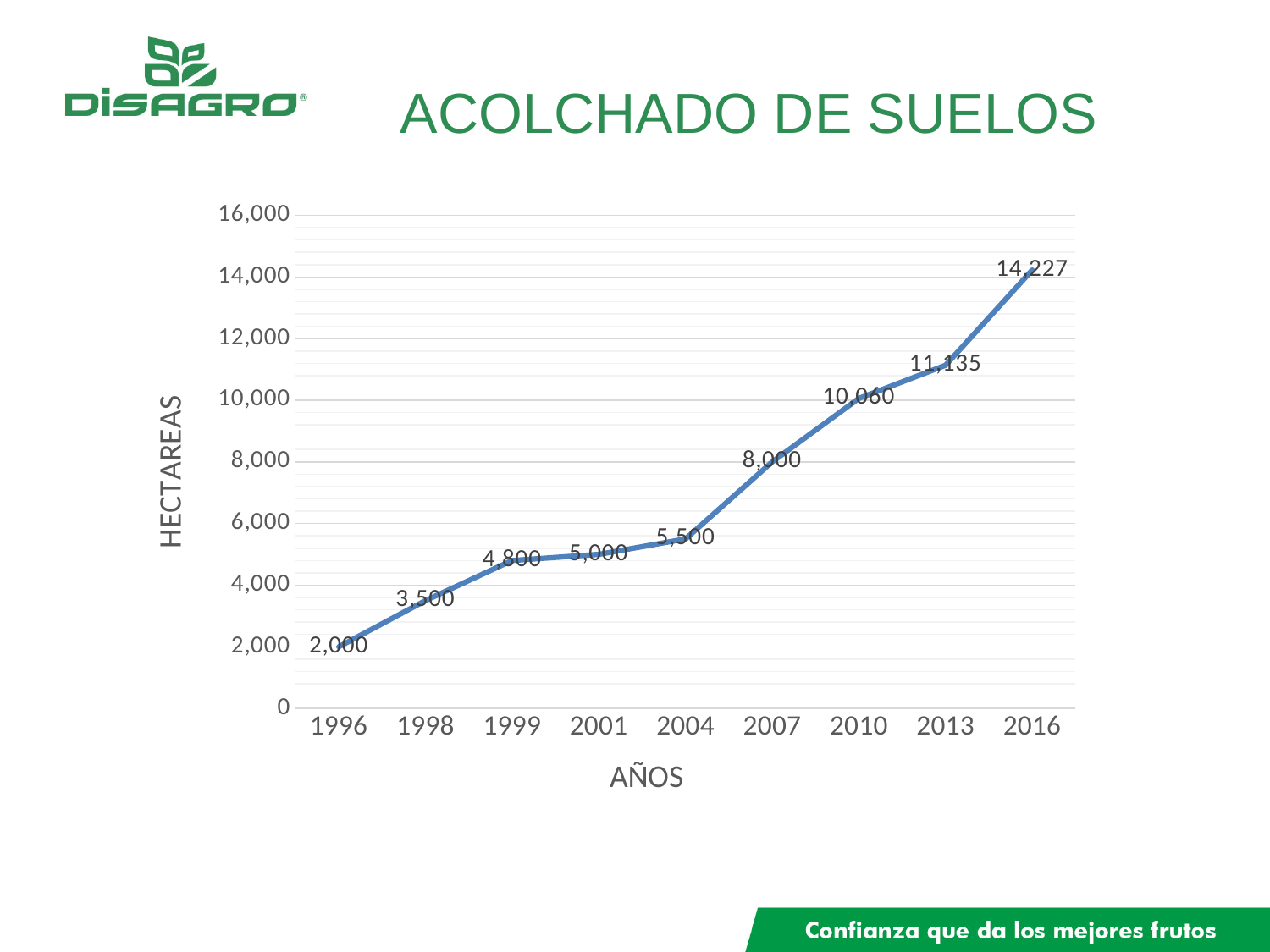
How many years are plotted on the x axis? 9 What is the value for 2010? 10,060 Do the values rise or fall from 1996 to 2016? rise Which year has the lowest value? 1996 What is the value for 2016? 14,227 Which is larger, the value for 1999 or the value for 2001? 2001 What is the difference between the values for 2007 and 2004? 2,500 Which year has the highest value? 2016 What is the value for 1996? 2,000 What is the difference between the values for 2016 and 2013? 3,092 Is the value for 2013 greater or less than 10,000? greater What kind of chart is shown? line chart